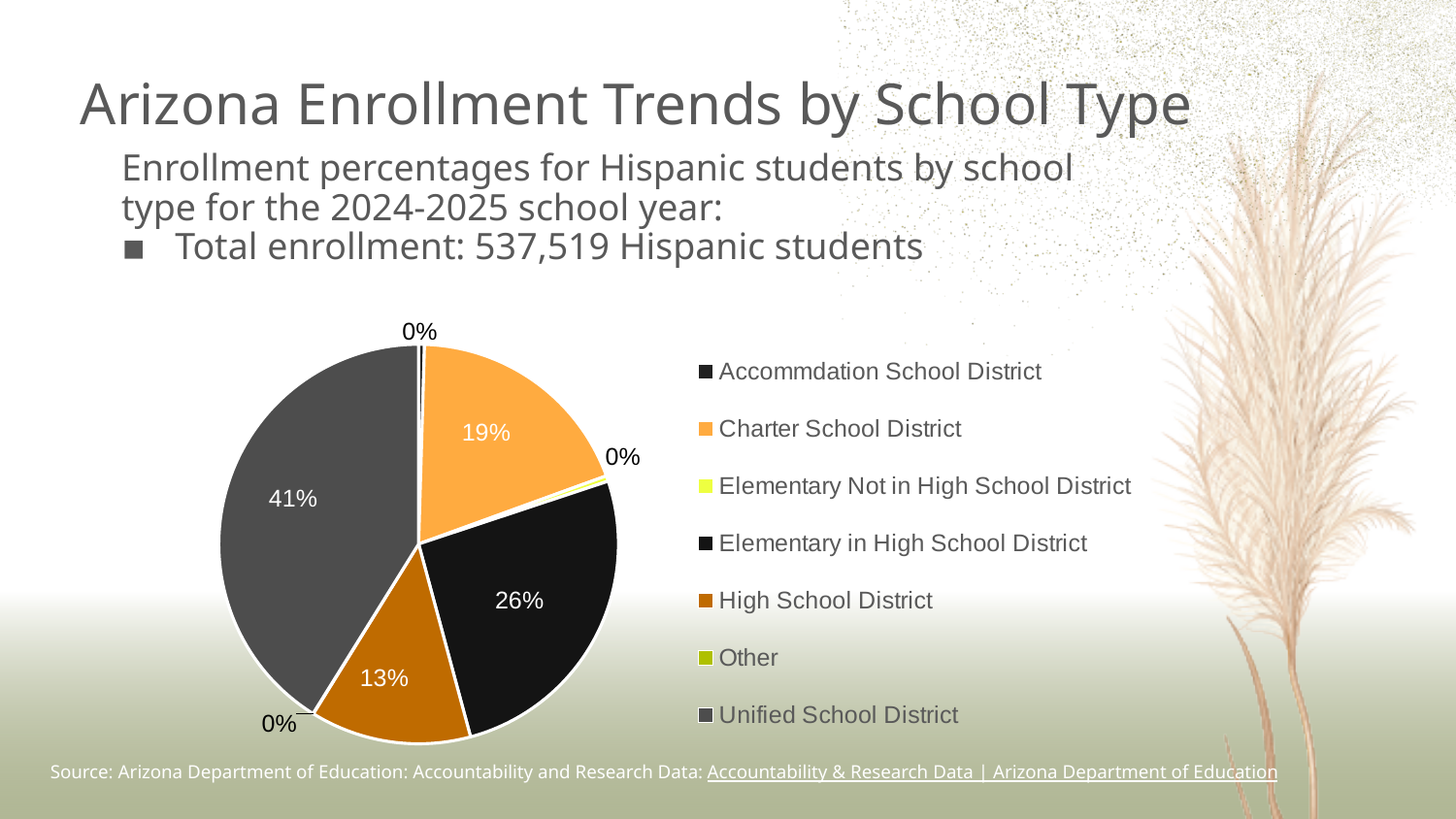
Which slice is larger, Charter School District or High School District? Charter School District How many categories does the legend of the pie chart list? 7 What percentage of Hispanic student enrollment is in the High School District category? 13% What is the combined share of the Charter School District and High School District slices? 32% What total enrollment figure for Hispanic students is stated on the slide? 537,519 What colour is the Charter School District slice in the pie chart? orange What is the difference in percentage points between the Unified School District and Elementary in High School District slices? 15 Which school type has the largest share of Hispanic student enrollment? Unified School District What type of chart is shown on the slide? pie chart What percentage of Hispanic student enrollment is in the Charter School District category? 19% What percentage of Hispanic student enrollment is in the Elementary in High School District category? 26% What percentage of Hispanic student enrollment is in the Unified School District category? 41%